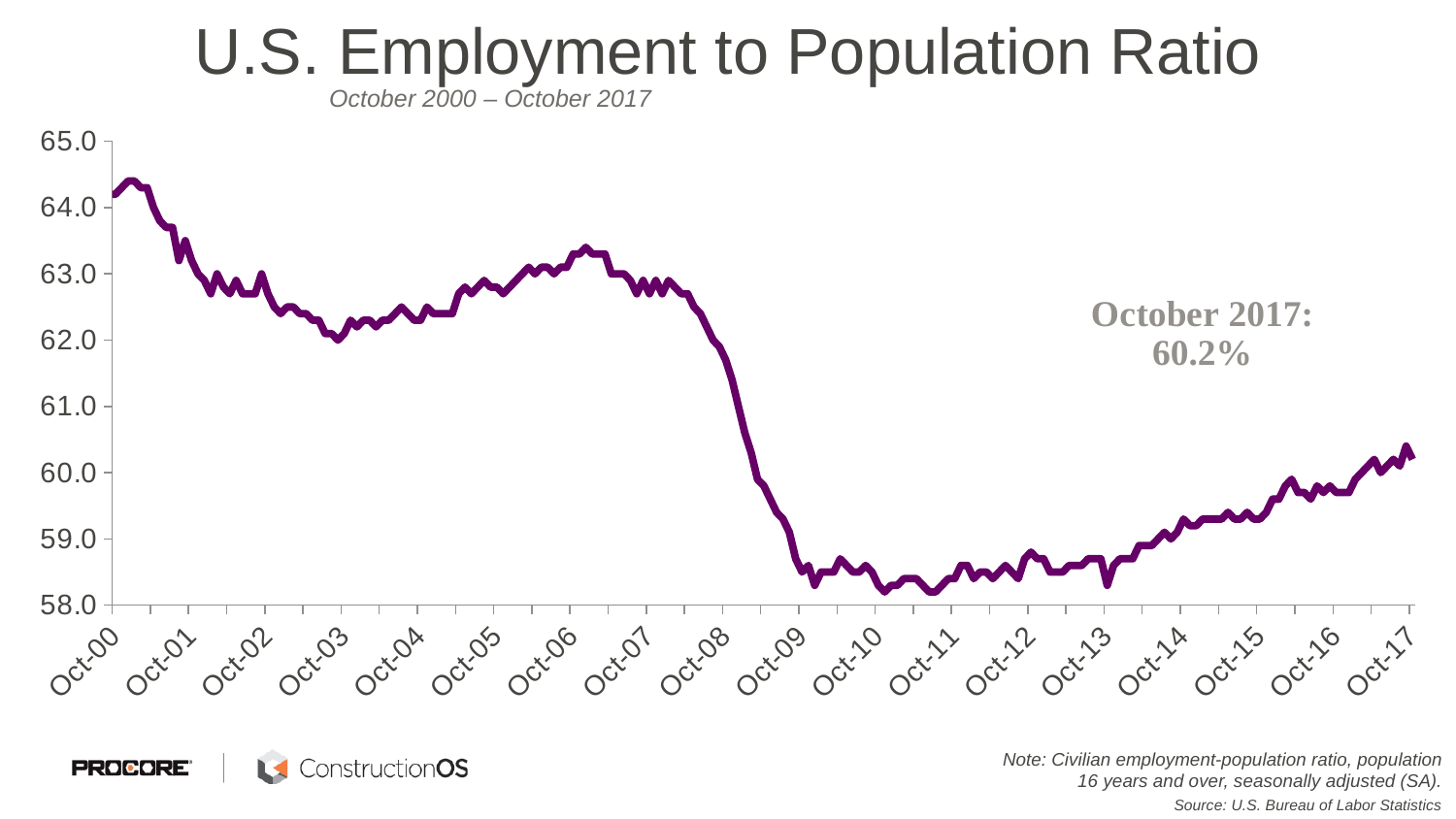
Does the line rise or fall between Oct-07 and Oct-09? fall Is the value at Oct-14 greater or less than 60.0? less What is the U.S. employment to population ratio for October 2017, as printed on the slide? 60.2% What kind of chart is shown on the slide? line chart Which is larger, the value at Oct-07 or the value at Oct-09? Oct-07 How many labelled points are there on the x axis? 18 Does the line rise or fall between Oct-13 and Oct-17? rise Is the value at Oct-06 greater or less than 62.0? greater Which is larger, the value at Oct-00 or the value at Oct-17? Oct-00 Is the value at Oct-10 greater or less than 59.0? less What period does the chart cover, according to the subtitle? October 2000 – October 2017